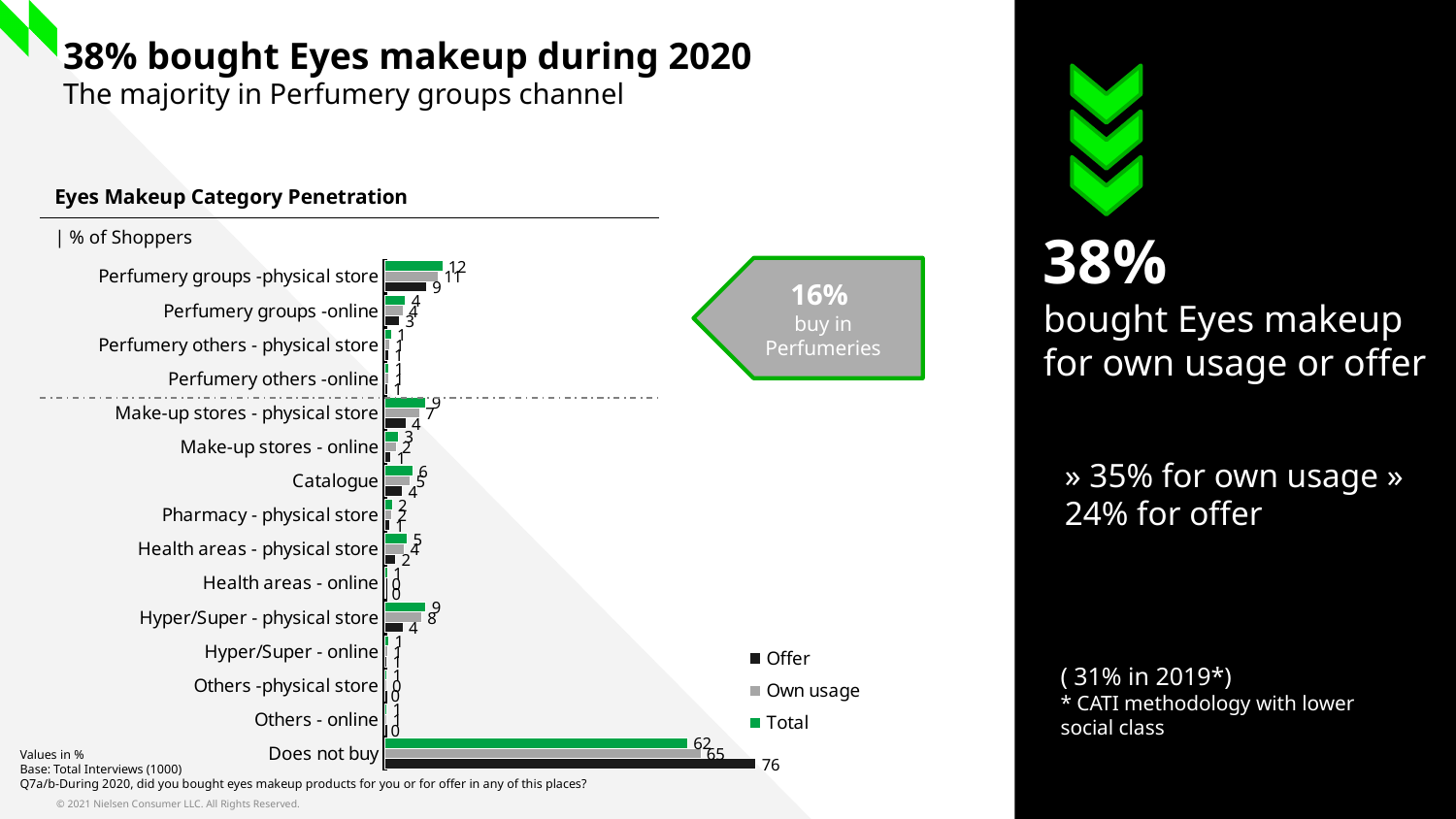
What is the Own usage value for Make-up stores - physical store? 7 What are the three series listed in the chart legend? Offer, Own usage, Total What kind of chart is shown on the slide? bar chart What is the Offer value for Does not buy? 76 Excluding Does not buy, which channel has the highest Total value? Perfumery groups - physical store What is the Own usage value for Does not buy? 65 What is the difference between the Total and Offer values for Perfumery groups - physical store? 3 What is the Total value for Perfumery groups - physical store? 12 Which has a larger Total value: Make-up stores - physical store or Catalogue? Make-up stores - physical store Which category has the highest Total value in the chart? Does not buy How many categories are shown on the chart's vertical axis? 15 How many series does the legend of the chart list? 3